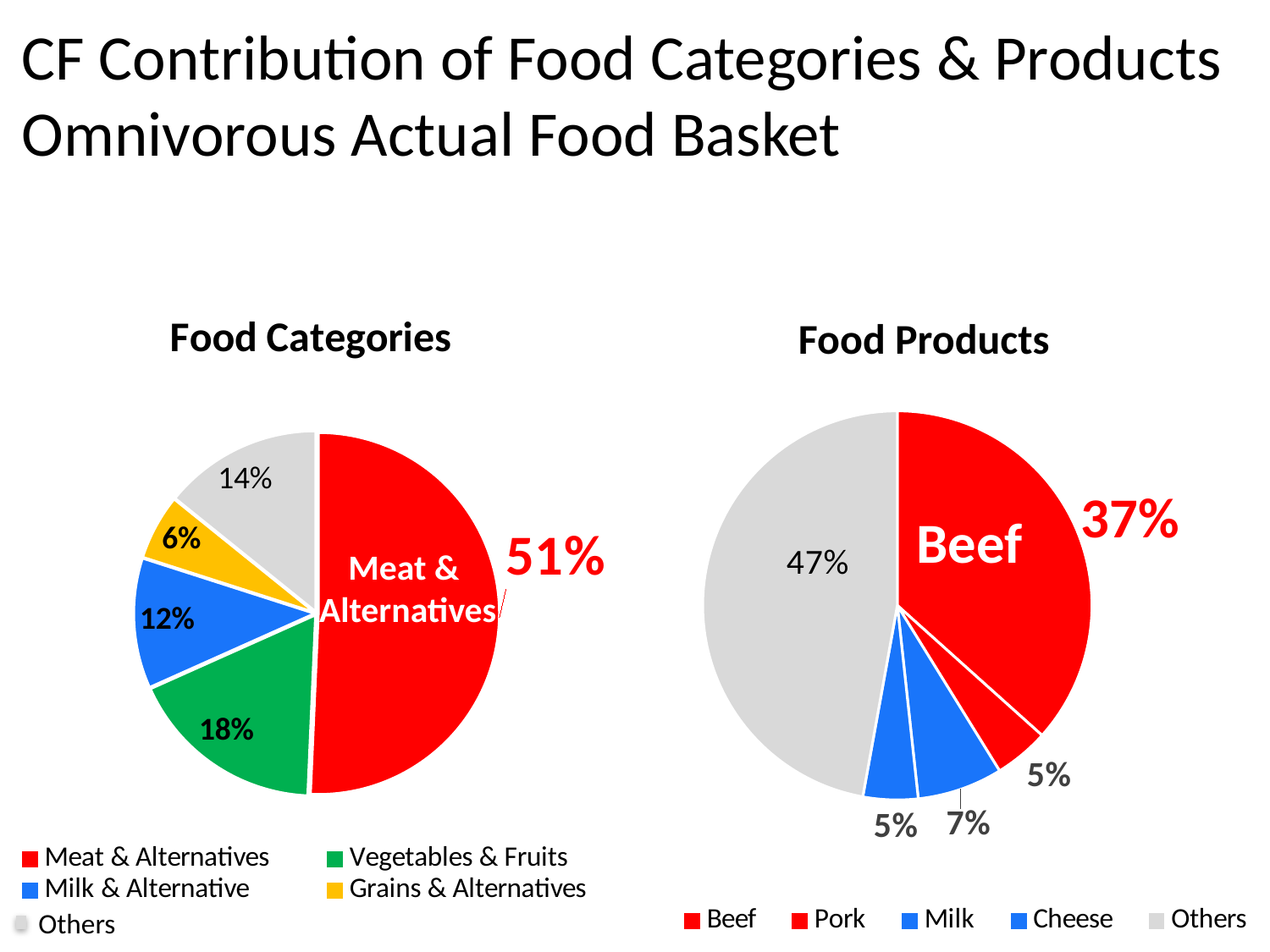
In the Food Categories chart, what share does Vegetables & Fruits have? 18% In the Food Categories chart, which category has the smallest share? Grains & Alternatives In the Food Products chart, how many slices are there? 5 What type of chart is the Food Categories chart? Pie chart In the Food Products chart, what share does Others have? 47% In the Food Products chart, which slice is the largest? Others In the Food Products chart, what share does Beef have? 37% In the Food Categories chart, which is larger: Milk & Alternative or Vegetables & Fruits? Vegetables & Fruits In the Food Categories chart, what share does Grains & Alternatives have? 6% In the Food Categories chart, what share does Milk & Alternative have? 12% In the Food Categories chart, what is the difference between the Meat & Alternatives share and the Others share? 37% In the Food Categories chart, what share does Meat & Alternatives have? 51%